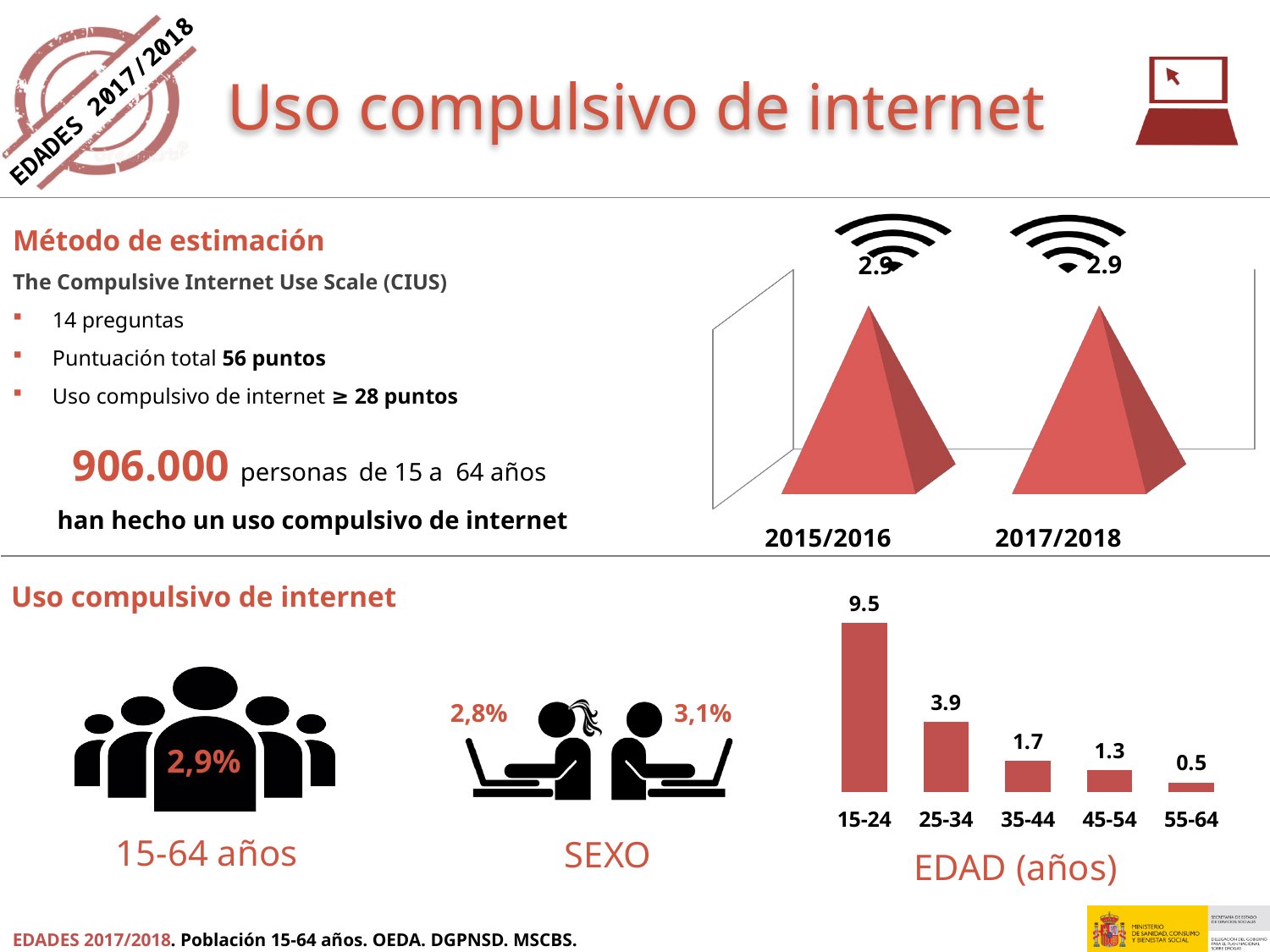
In the bar chart by age (EDAD (años)), which age group has the lowest value? 55-64 How many periods are shown in the pyramid chart at the top right of the slide? 2 In the bar chart by age (EDAD (años)), what is the value for the 55-64 age group? 0.5 In the bar chart by age (EDAD (años)), what is the difference between the values for 15-24 and 25-34? 5.6 In the bar chart by age (EDAD (años)), which age group has the highest value? 15-24 What kind of chart is the chart by age (EDAD (años)) at the bottom right of the slide? bar chart In the bar chart by age (EDAD (años)), what is the value for the 35-44 age group? 1.7 In the bar chart by age (EDAD (años)), what is the value for the 15-24 age group? 9.5 How many age groups are shown in the bar chart by age (EDAD (años))? 5 In the bar chart by age (EDAD (años)), do the values rise or fall as age increases along the x axis? fall In the pyramid chart at the top right, what is the value for 2017/2018? 2.9 In the bar chart by age (EDAD (años)), which is larger, the value for 45-54 or the value for 55-64? 45-54